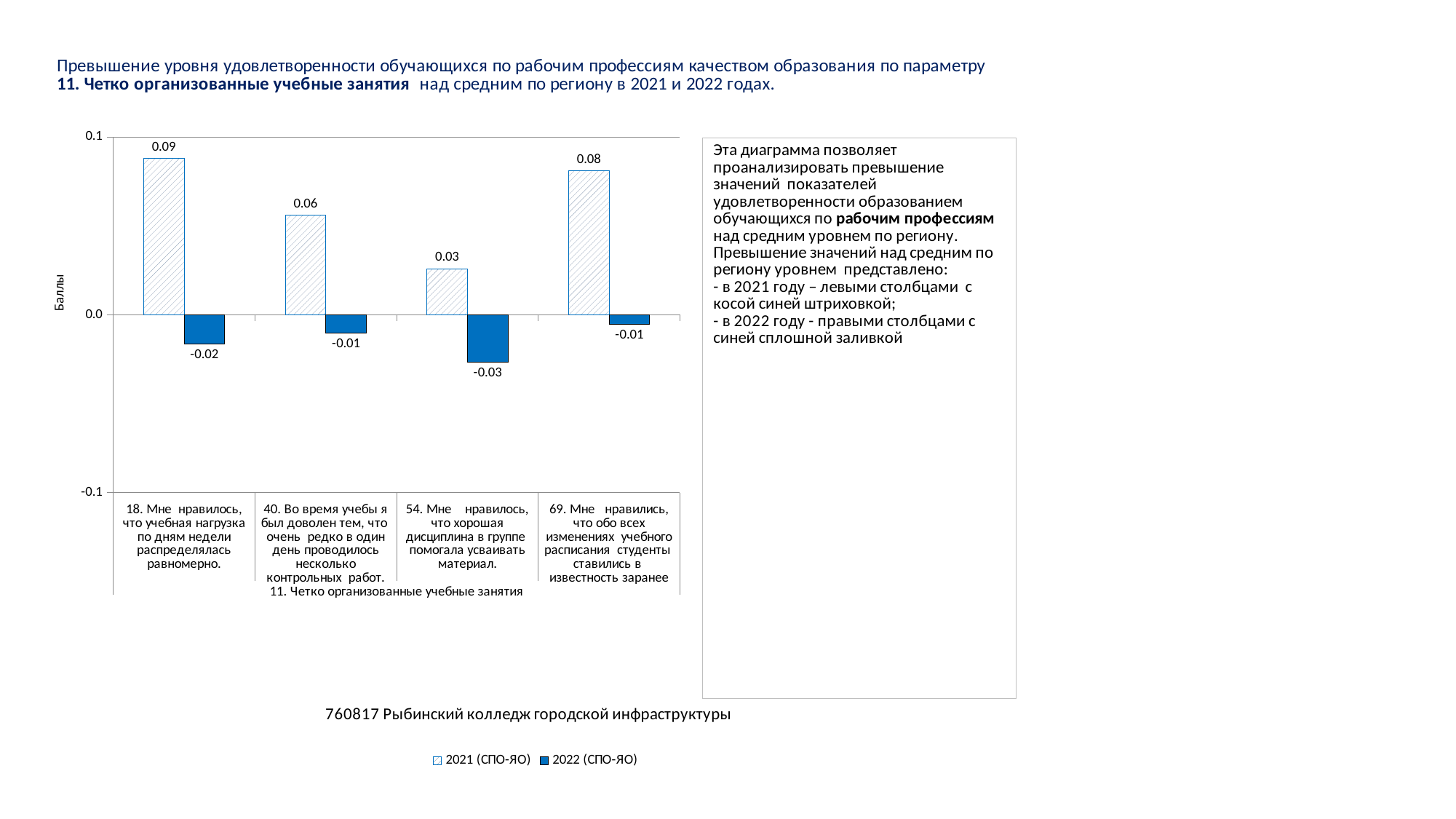
What is the 2021 (СПО-ЯО) value for category 69 ("Мне нравились, что обо всех изменениях учебного расписания студенты ставились в известность заранее")? 0.08 What is the difference between the 2021 (СПО-ЯО) value and the 2022 (СПО-ЯО) value for category 40? 0.07 What is the 2021 (СПО-ЯО) value for category 18 ("Мне нравилось, что учебная нагрузка по дням недели распределялась равномерно")? 0.09 Which series is shown with solid blue fill according to the legend? 2022 (СПО-ЯО) What is the label of the vertical axis of the chart? Баллы What is the 2022 (СПО-ЯО) value for category 54 ("Мне нравилось, что хорошая дисциплина в группе помогала усваивать материал")? -0.03 How many series does the legend list? 2 Which category has the highest 2021 (СПО-ЯО) value? 18. Мне нравилось, что учебная нагрузка по дням недели распределялась равномерно. What kind of chart is shown on the slide? Bar chart Which is larger: the 2021 (СПО-ЯО) value for category 40 or the 2021 (СПО-ЯО) value for category 54? Category 40 How many categories are shown on the x axis of the chart? 4 Which category has the lowest 2022 (СПО-ЯО) value? 54. Мне нравилось, что хорошая дисциплина в группе помогала усваивать материал.